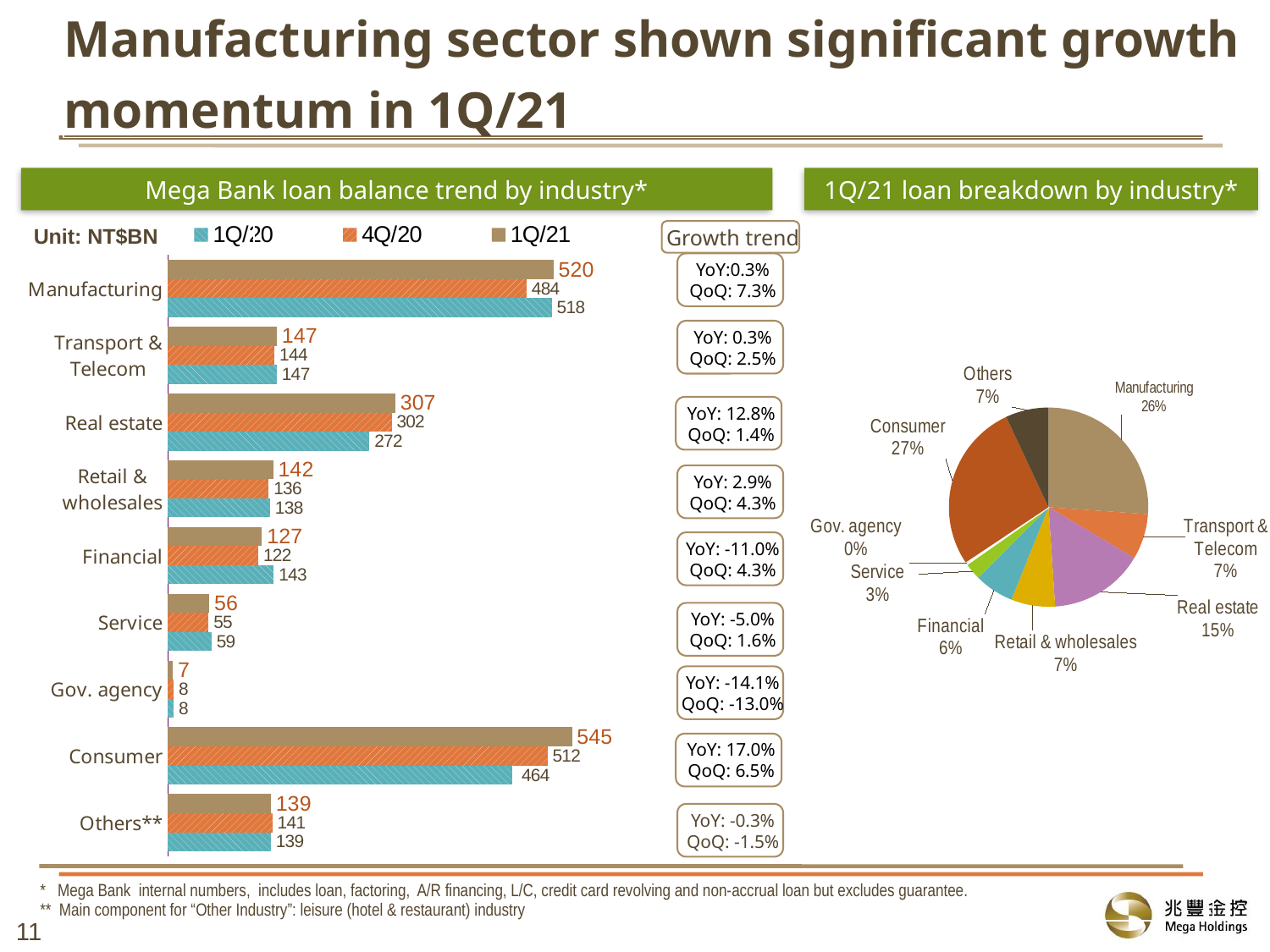
In the '1Q/21 loan breakdown by industry' pie chart, what share does Real estate have? 15% In the 'Mega Bank loan balance trend by industry' chart, what is the difference between the 1Q/21 and 4Q/20 loan balances for Consumer? 33 In the 'Mega Bank loan balance trend by industry' chart, which industry has the highest 1Q/21 loan balance? Consumer In the 'Mega Bank loan balance trend by industry' chart, what is the 4Q/20 loan balance for Real estate? 302 In the 'Mega Bank loan balance trend by industry' chart, is the Financial loan balance larger in 1Q/20 or in 1Q/21? 1Q/20 How many series does the legend of the 'Mega Bank loan balance trend by industry' chart list? 3 In the 'Mega Bank loan balance trend by industry' chart, what is the 1Q/21 loan balance for Manufacturing? 520 In the '1Q/21 loan breakdown by industry' pie chart, which industry has the largest share? Consumer How many industry categories are shown in the 'Mega Bank loan balance trend by industry' chart? 9 In the 'Mega Bank loan balance trend by industry' chart, which industry has the lowest 1Q/21 loan balance? Gov. agency What type of chart is the 'Mega Bank loan balance trend by industry' chart? Bar chart In the 'Mega Bank loan balance trend by industry' chart, what is the 1Q/20 loan balance for Consumer? 464